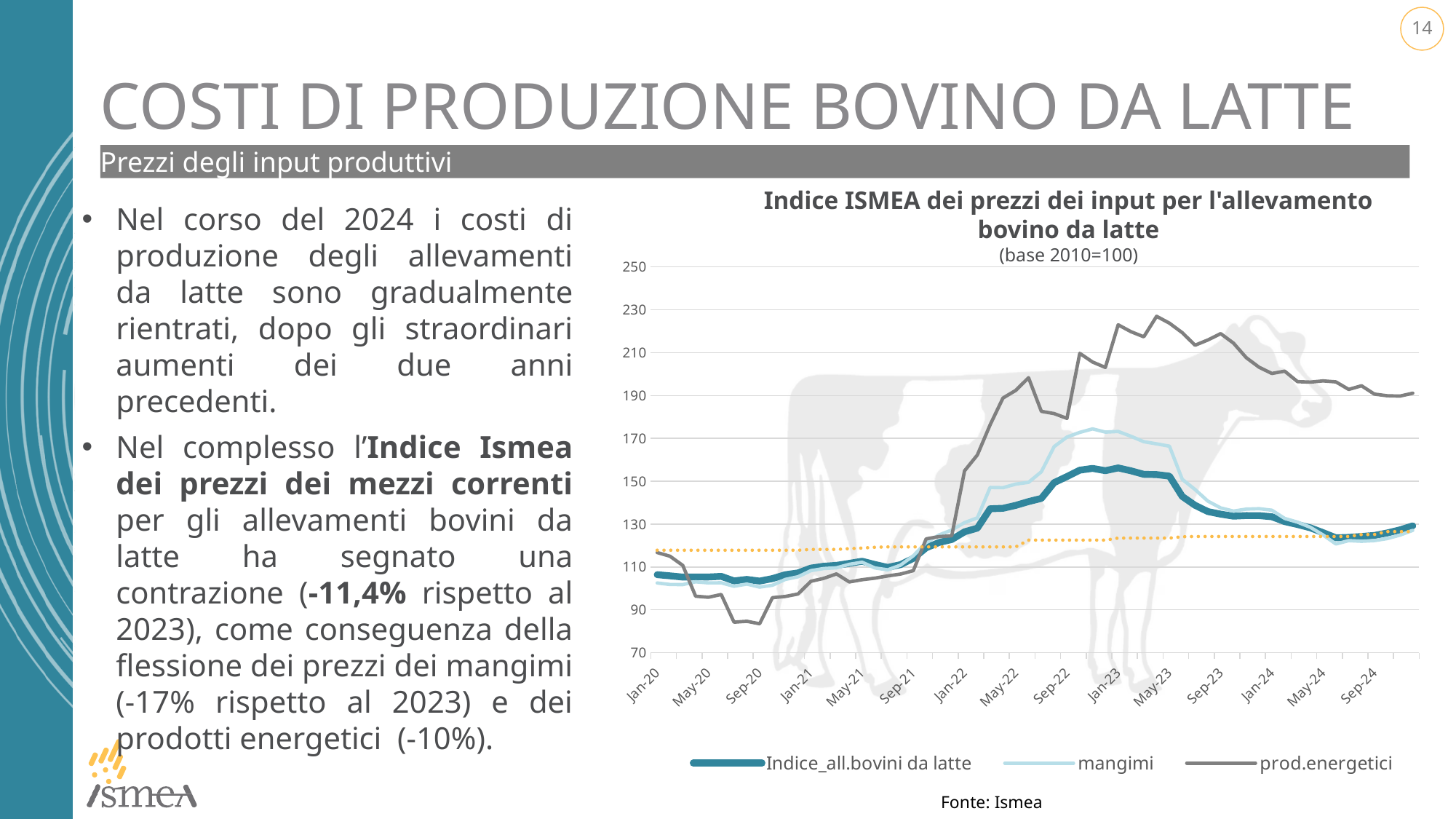
What kind of chart is shown on the slide? line chart Is the value of prod.energetici at Sep-20 greater or less than 110? less Is the value of prod.energetici at Jan-23 greater or less than 210? greater How many series does the chart legend list? 3 What is the base year stated under the chart title? base 2010=100 Which series has the highest value at Jan-23? prod.energetici Does the prod.energetici series rise or fall between Jan-23 and Sep-24? fall At Jan-23, which is larger: prod.energetici or mangimi? prod.energetici Is the value of prod.energetici at Sep-24 greater or less than 170? greater What is the source cited below the chart? Ismea Which series has the lowest value at Sep-20? prod.energetici